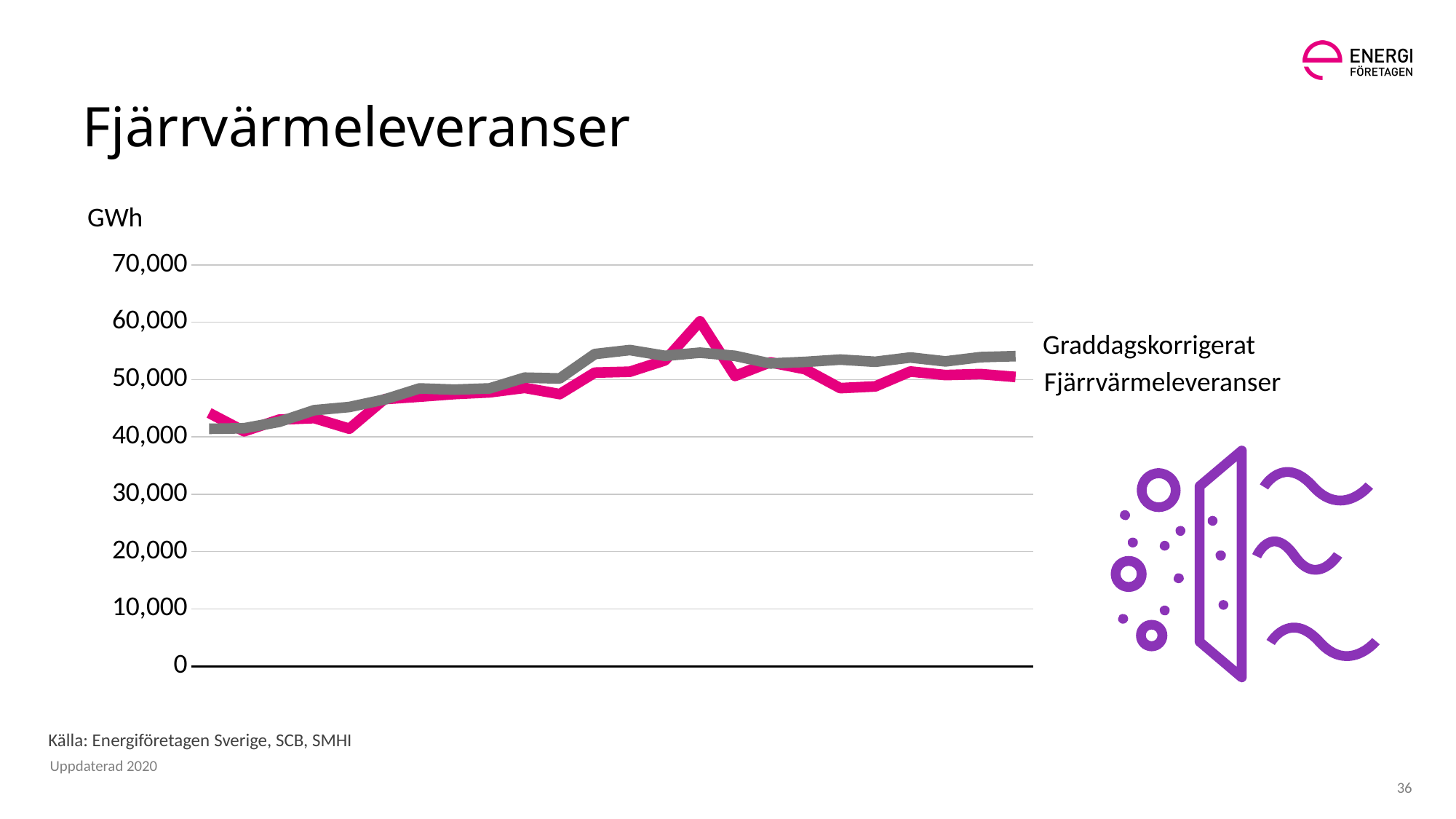
Are any values in the chart greater than 70,000? no What kind of chart is shown on the slide? line chart Is the lowest value of the Graddagskorrigerat series greater or less than 30,000? greater Is the highest value of the Fjärrvärmeleveranser series greater or less than 50,000? greater What unit is shown on the y axis of the chart? GWh What is the highest value shown on the y axis? 70,000 How many series does the chart show? 2 Do the values of the Graddagskorrigerat series generally rise or fall from left to right? rise Which series reaches the highest single value in the chart? Fjärrvärmeleveranser What are the names of the two series in the chart? Graddagskorrigerat and Fjärrvärmeleveranser